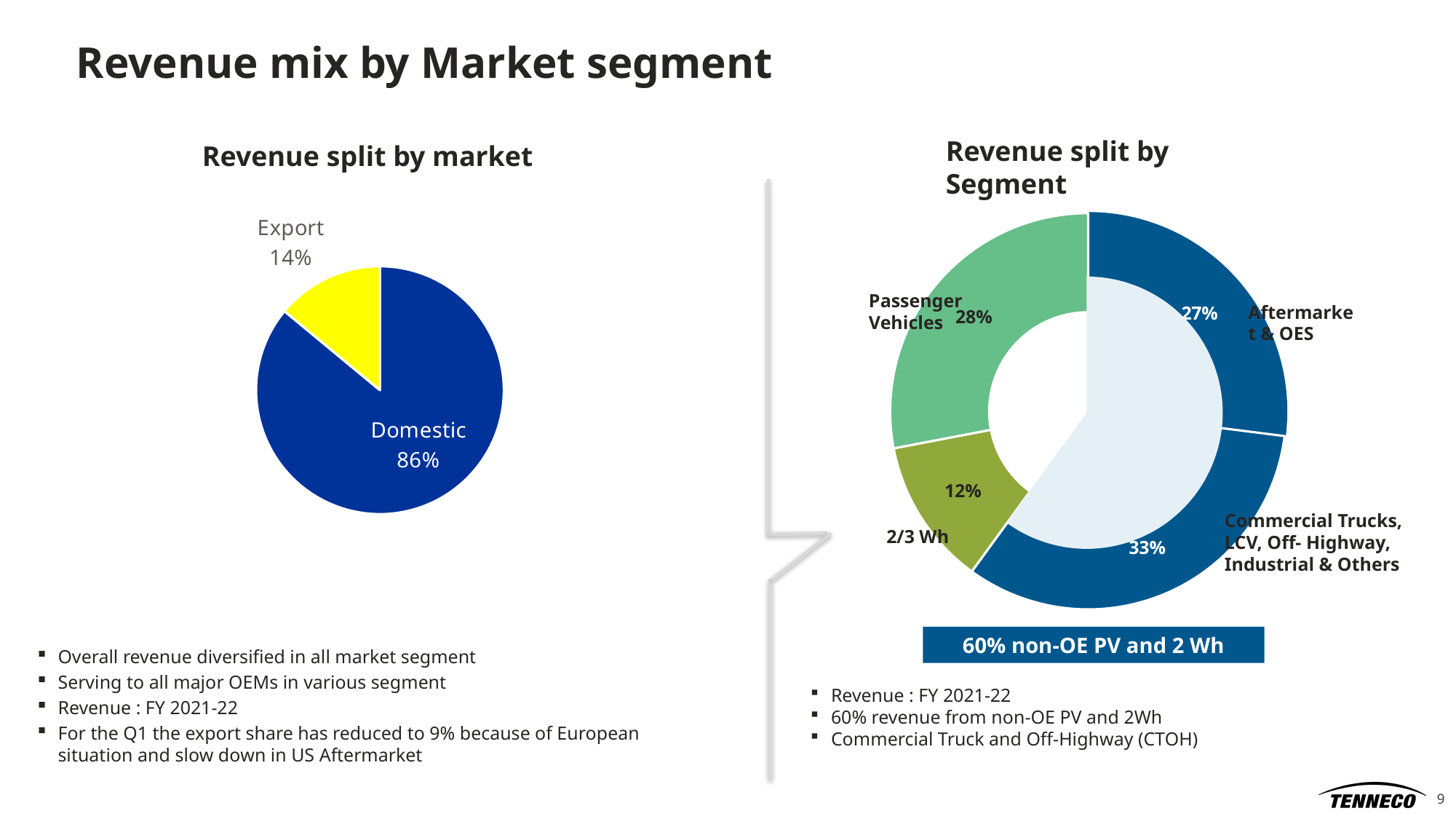
In the 'Revenue split by Segment' chart, how many segments are shown? 4 In the 'Revenue split by Segment' chart, what share do Passenger Vehicles have? 28% In the 'Revenue split by Segment' chart, what share does Aftermarket & OES have? 27% In the 'Revenue split by market' chart, which category has the largest share? Domestic In the 'Revenue split by Segment' chart, what is the difference between the Commercial Trucks, LCV, Off- Highway, Industrial & Others share and the 2/3 Wh share? 21% What kind of chart is the 'Revenue split by market' chart? Pie chart In the 'Revenue split by market' chart, what is the difference between the Domestic and Export shares? 72% In the 'Revenue split by Segment' chart, which segment has the smallest share? 2/3 Wh In the 'Revenue split by Segment' chart, what share does 2/3 Wh have? 12% In the 'Revenue split by market' chart, what share does Domestic have? 86% In the 'Revenue split by market' chart, what share does Export have? 14% In the 'Revenue split by Segment' chart, which segment has the largest share? Commercial Trucks, LCV, Off- Highway, Industrial & Others